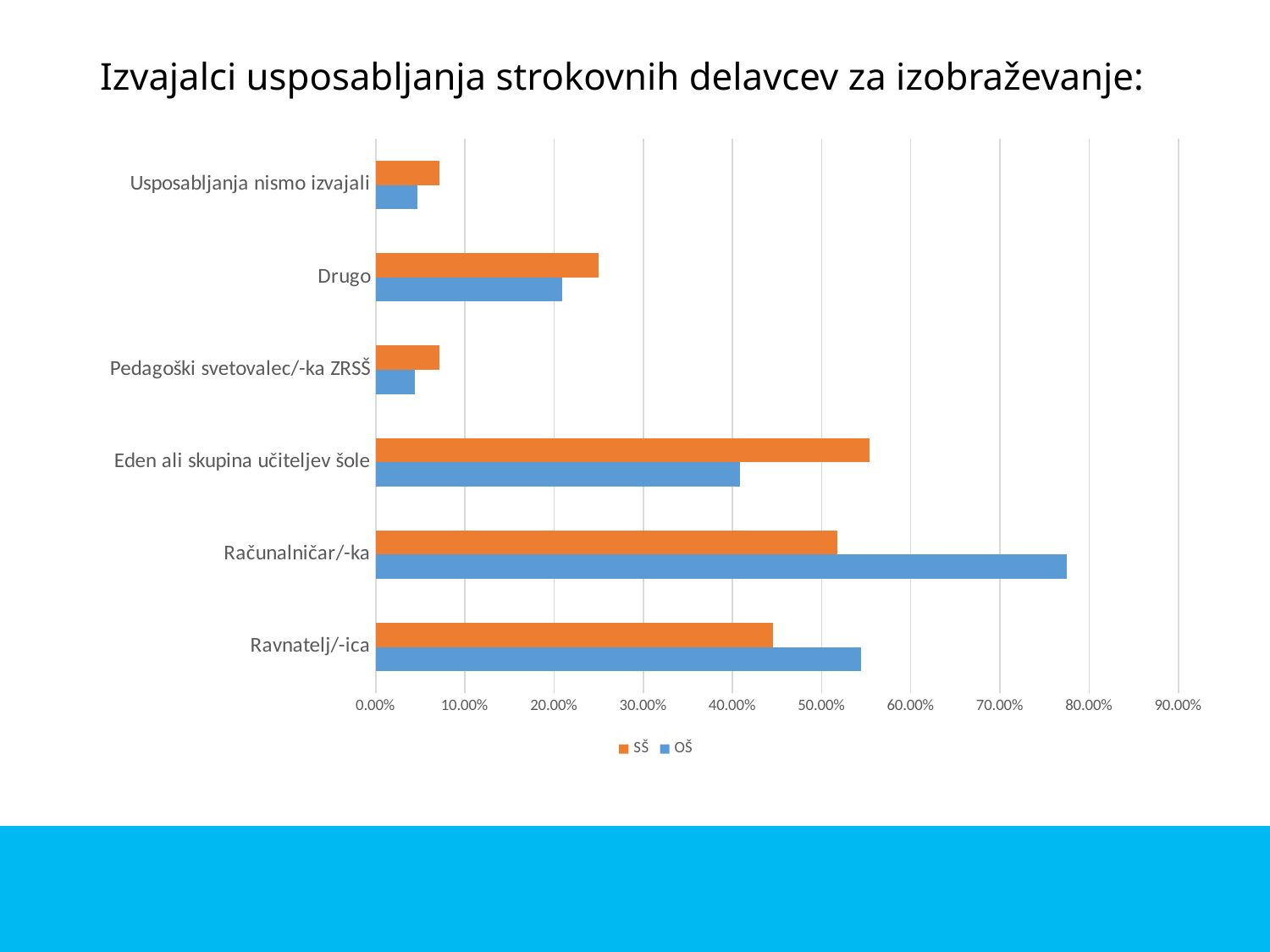
Is the OŠ value for Eden ali skupina učiteljev šole greater or less than 50%? less How many categories are shown on the chart? 6 For Računalničar/-ka, which series has the larger value, SŠ or OŠ? OŠ Is the OŠ value for Računalničar/-ka greater or less than 70%? greater How many series does the legend list? 2 Which colour represents the SŠ series in the legend? orange For Eden ali skupina učiteljev šole, which series has the larger value, SŠ or OŠ? SŠ Which category has the highest value for the OŠ series? Računalničar/-ka What kind of chart is shown on the slide? bar chart For Ravnatelj/-ica, which series has the larger value, SŠ or OŠ? OŠ Is the SŠ value for Drugo greater or less than 20%? greater